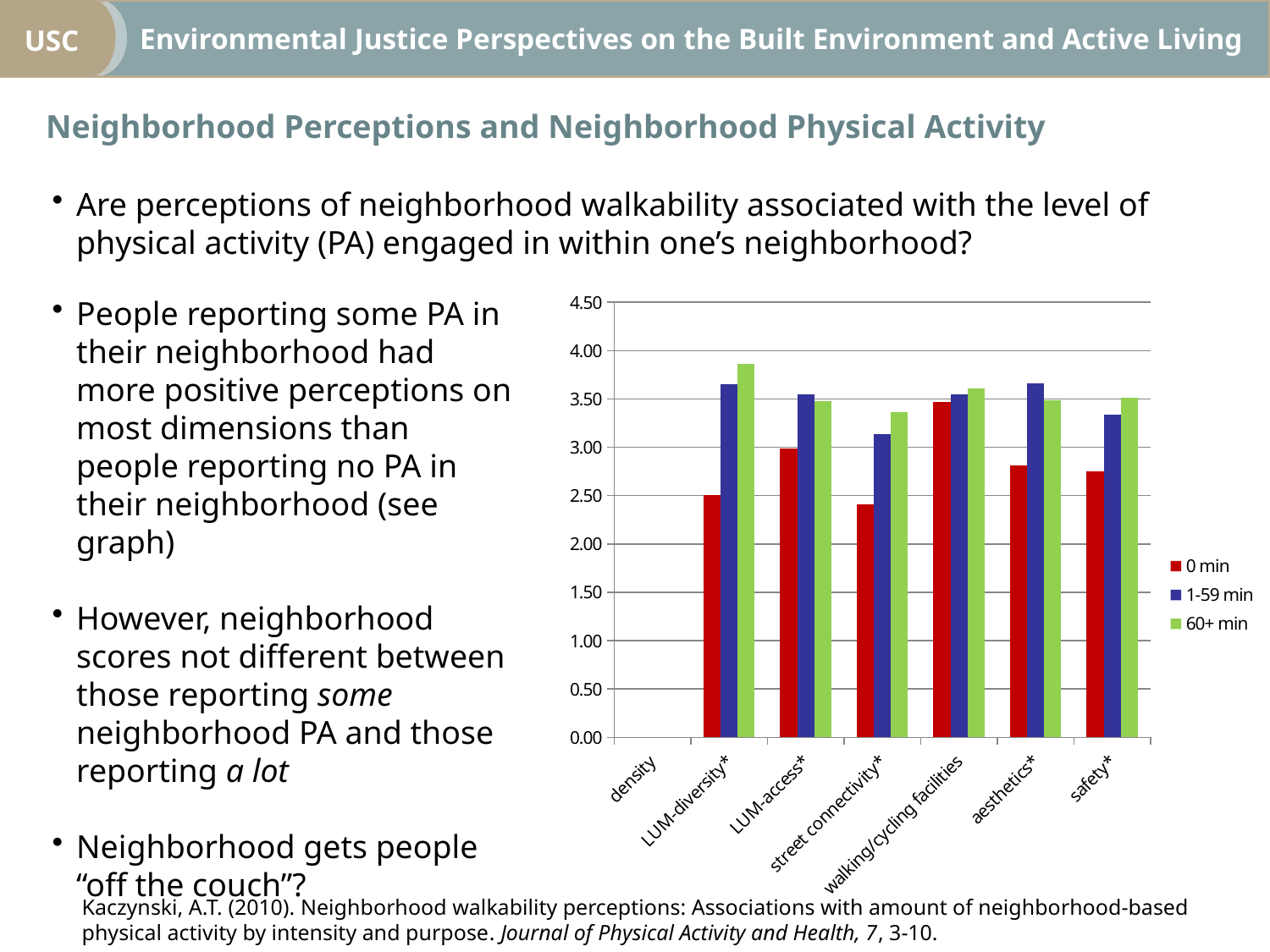
How many series does the chart legend list? 3 Which is larger: the 0 min value for LUM-diversity* or the 0 min value for walking/cycling facilities? walking/cycling facilities Is the 0 min value for safety* greater or less than 3.00? less What are the three series named in the chart legend? 0 min, 1-59 min, 60+ min Which is larger: the 60+ min value for LUM-diversity* or the 60+ min value for safety*? LUM-diversity* What kind of chart is shown on the slide? bar chart Is the 0 min value for street connectivity* greater or less than 2.50? less Within the LUM-diversity* category, which series has the lowest bar? 0 min Which category has the tallest bar in the chart? LUM-diversity* How many categories are labelled along the x axis of the chart? 7 Is the 60+ min value for LUM-diversity* greater or less than 3.50? greater